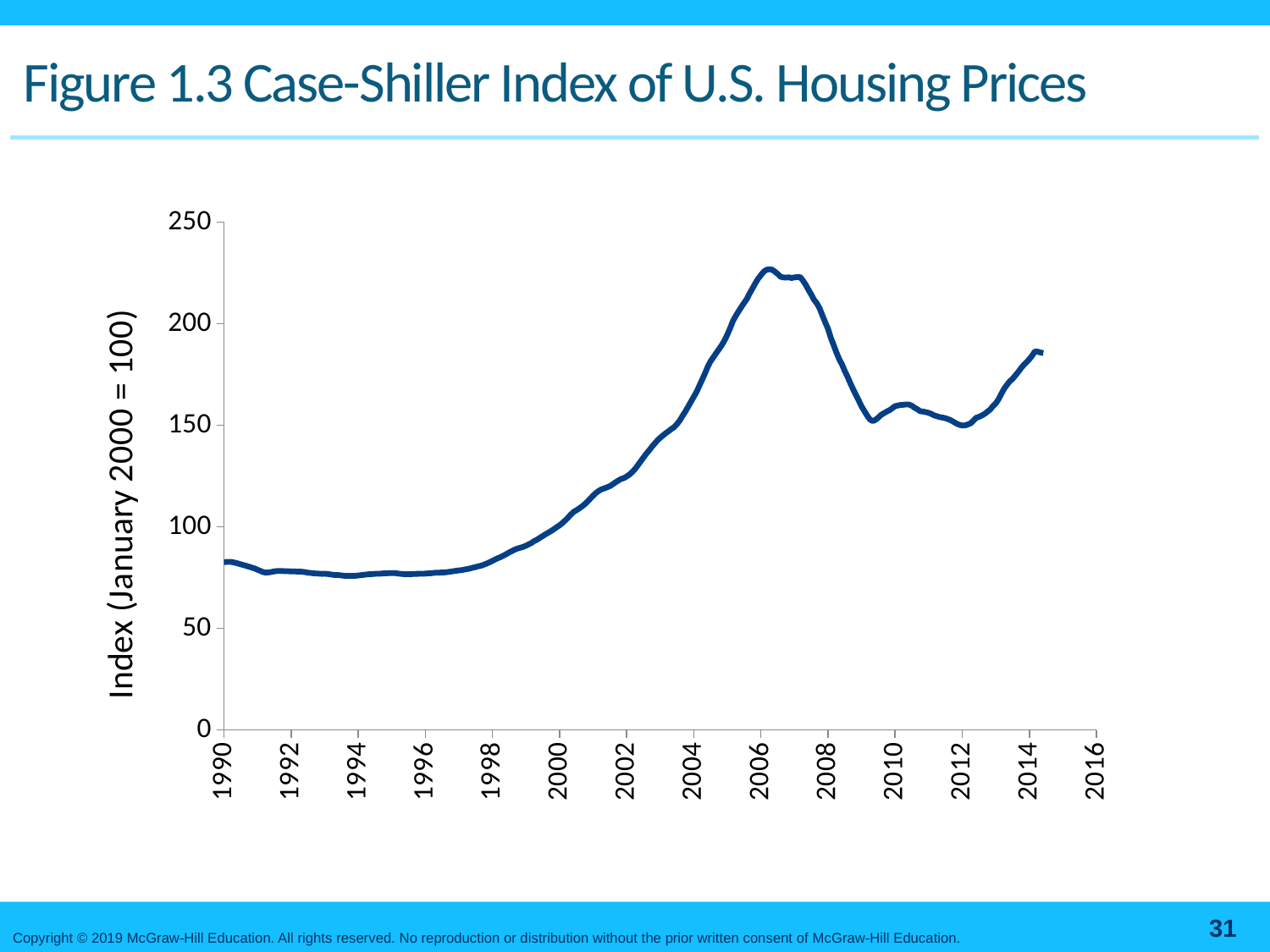
Is the value of the index in 2014 greater or less than 150? greater Does the index rise or fall between 2006 and 2009? fall Does the index rise or fall between 2000 and 2006? rise Is the value of the index in 2012 greater or less than 100? greater Is the value of the index in 1990 greater or less than 100? less Which year has the higher index value, 2006 or 2014? 2006 What is the label on the vertical axis of the chart? Index (January 2000 = 100) Around which year does the Case-Shiller index reach its highest value? 2006 What kind of chart is shown on the slide? line chart What is the title of the chart on the slide? Figure 1.3 Case-Shiller Index of U.S. Housing Prices